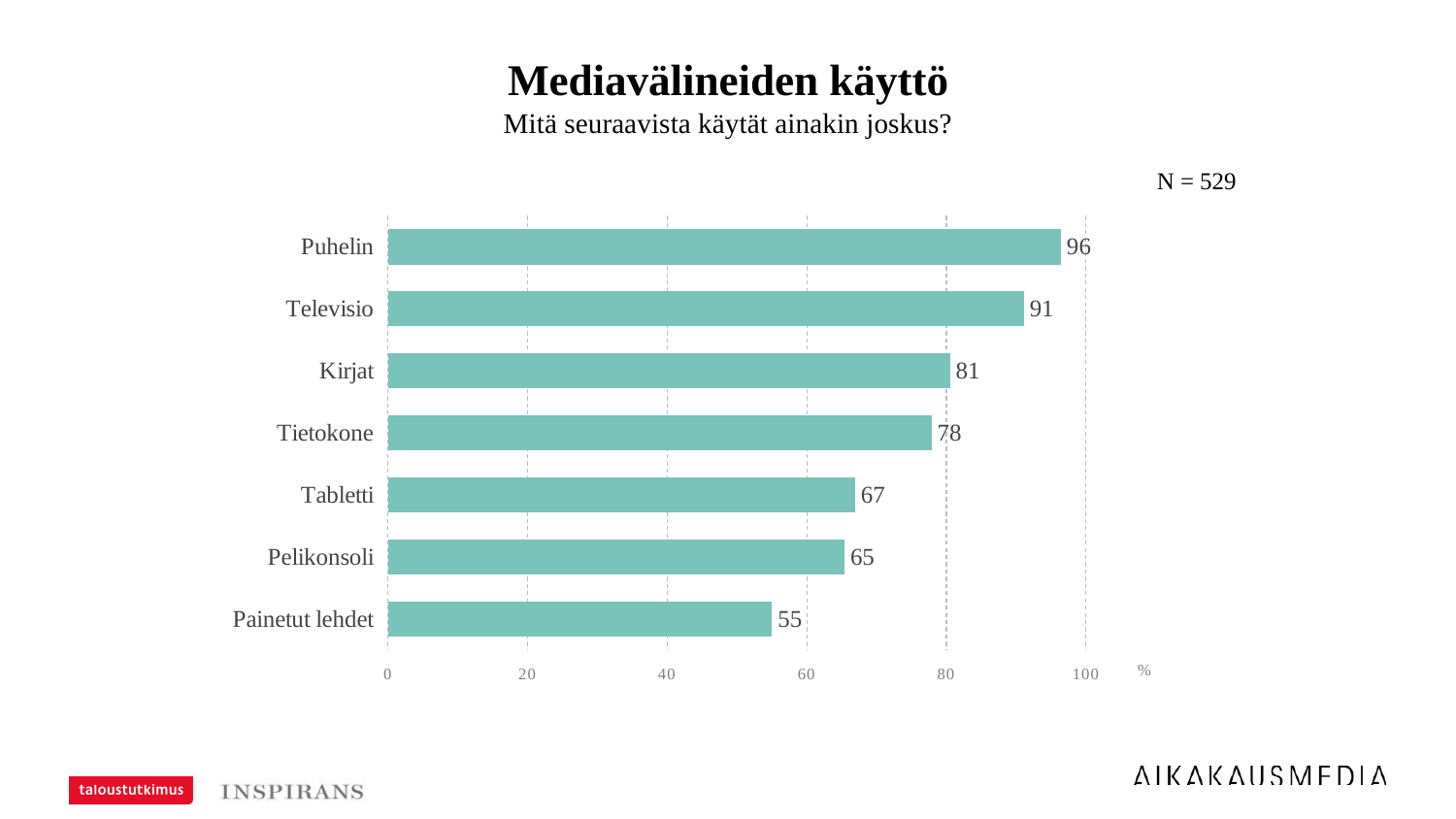
Is the value for Kirjat greater or less than 80? greater What is the difference between the values for Puhelin and Painetut lehdet? 41 What is the value for Puhelin? 96 Which is larger, the value for Tabletti or the value for Pelikonsoli? Tabletti What kind of chart is shown on the slide? bar chart Which category has the highest value? Puhelin How many categories are shown in the chart? 7 Which category has the lowest value? Painetut lehdet What is the value for Painetut lehdet? 55 What is the difference between the values for Televisio and Kirjat? 10 What is the value for Tietokone? 78 What is the title of the chart? Mediavälineiden käyttö